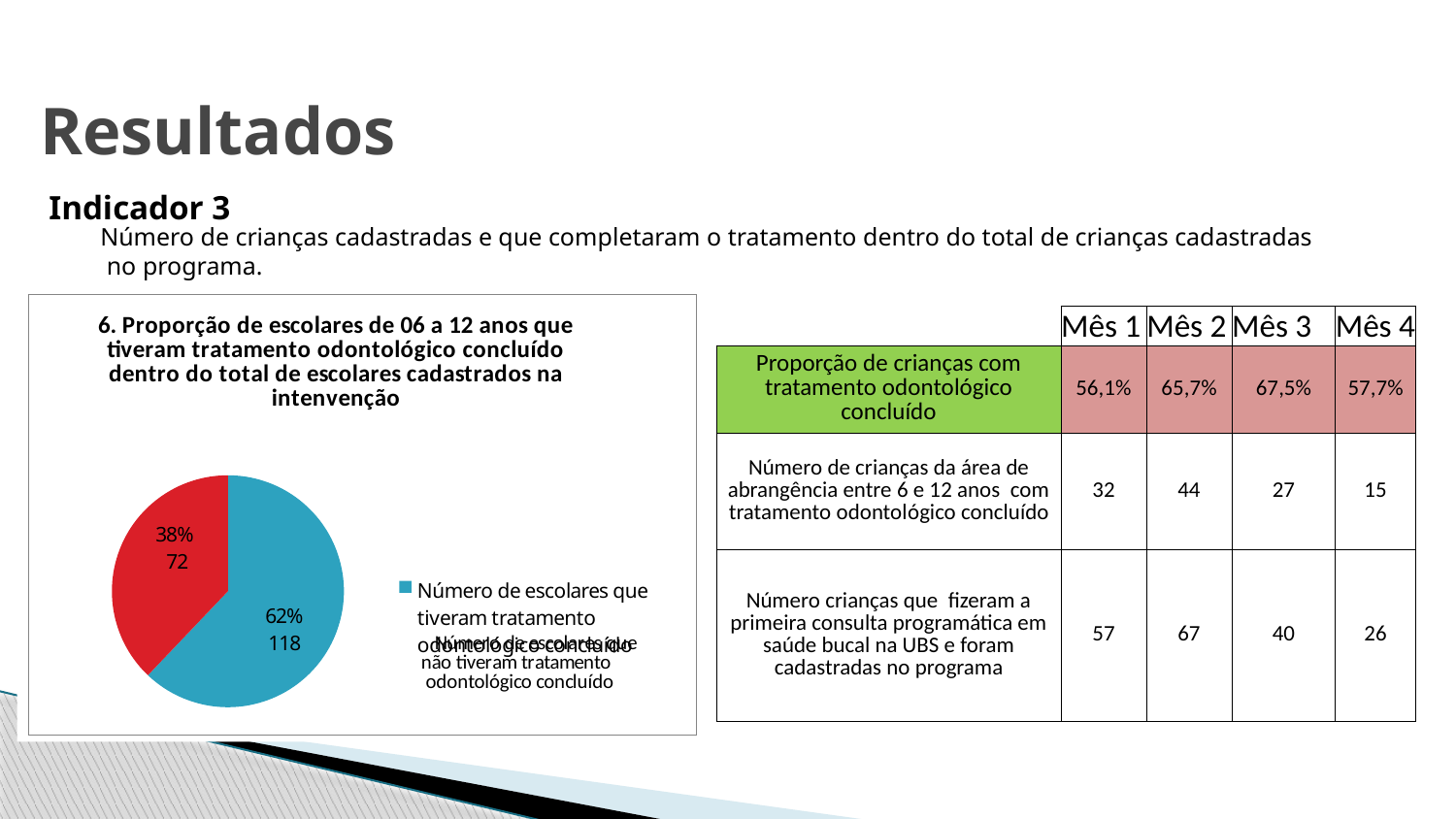
What colour is the slice representing escolares que não tiveram tratamento odontológico concluído? red How many slices does the pie chart have? 2 What is the number of escolares que tiveram tratamento odontológico concluído shown on the pie chart? 118 What share of the pie does the slice for 'Número de escolares que tiveram tratamento odontológico concluído' represent? 62% What kind of chart is shown on the slide? pie chart Which is larger: the number of escolares who completed dental treatment or the number who did not? the number who completed dental treatment Which slice of the pie chart is the smallest? Número de escolares que não tiveram tratamento odontológico concluído What is the difference between the number of escolares who completed treatment (118) and those who did not (72)? 46 Which slice of the pie chart is the largest? Número de escolares que tiveram tratamento odontológico concluído What share of the pie does the slice for 'Número de escolares que não tiveram tratamento odontológico concluído' represent? 38% What is the total number of escolares represented in the pie chart? 190 What is the number of escolares que não tiveram tratamento odontológico concluído shown on the pie chart? 72